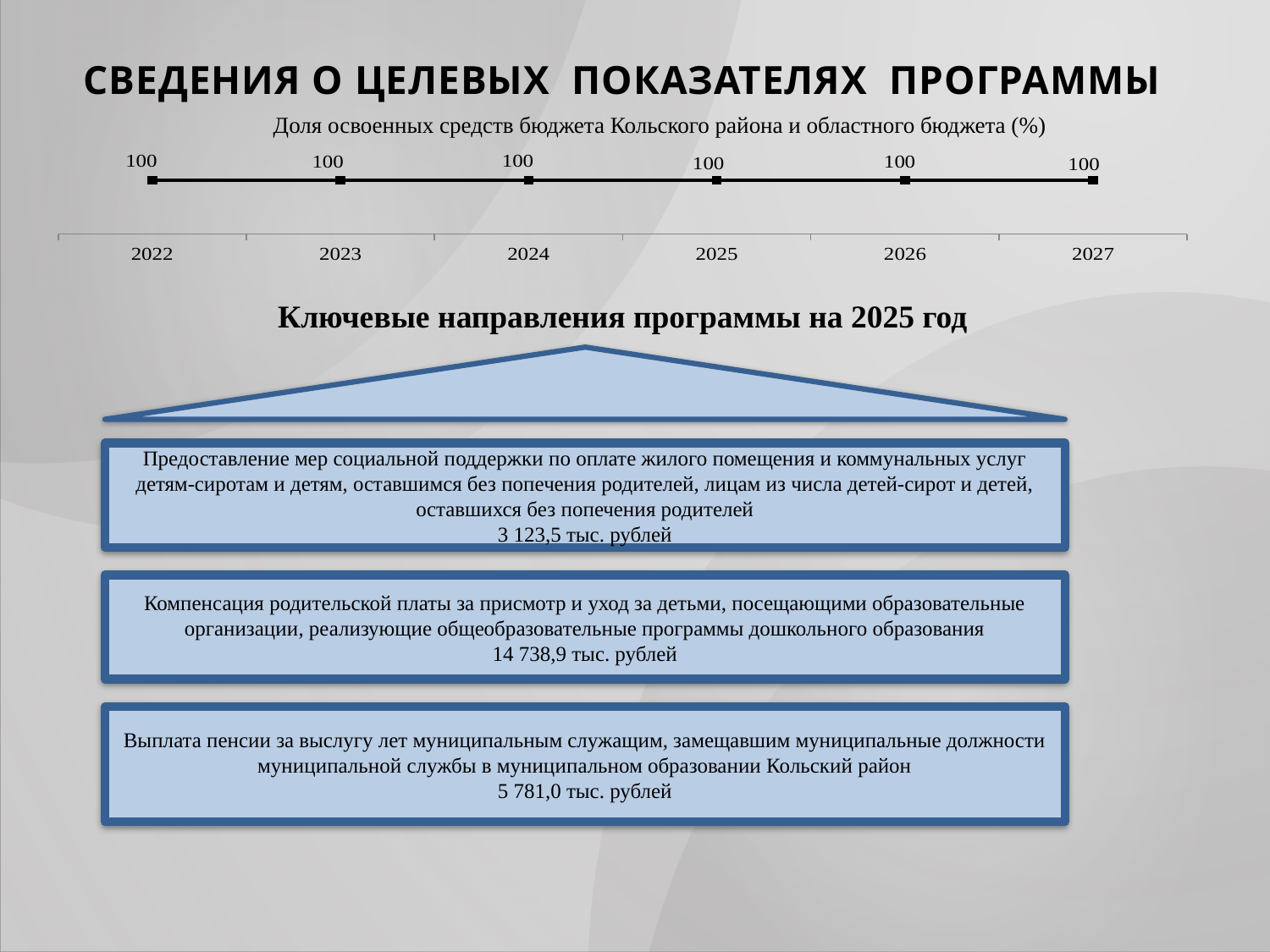
What is the value for 2027 in the chart "Доля освоенных средств бюджета Кольского района и областного бюджета (%)"? 100 What is the value for 2022 in the chart "Доля освоенных средств бюджета Кольского района и областного бюджета (%)"? 100 How many years (data points) are plotted in the chart "Доля освоенных средств бюджета Кольского района и областного бюджета (%)"? 6 What is the title of the line chart on the slide? Доля освоенных средств бюджета Кольского района и областного бюджета (%) What is the first year shown on the x axis of the chart "Доля освоенных средств бюджета Кольского района и областного бюджета (%)"? 2022 Do the values in the chart "Доля освоенных средств бюджета Кольского района и областного бюджета (%)" rise, fall, or stay the same from 2022 to 2027? stay the same What kind of chart is "Доля освоенных средств бюджета Кольского района и областного бюджета (%)"? line chart What is the value for 2025 in the chart "Доля освоенных средств бюджета Кольского района и областного бюджета (%)"? 100 What is the difference between the values for 2023 and 2026 in the chart "Доля освоенных средств бюджета Кольского района и областного бюджета (%)"? 0 Is the value for 2024 larger than, smaller than, or equal to the value for 2025 in the chart "Доля освоенных средств бюджета Кольского района и областного бюджета (%)"? equal